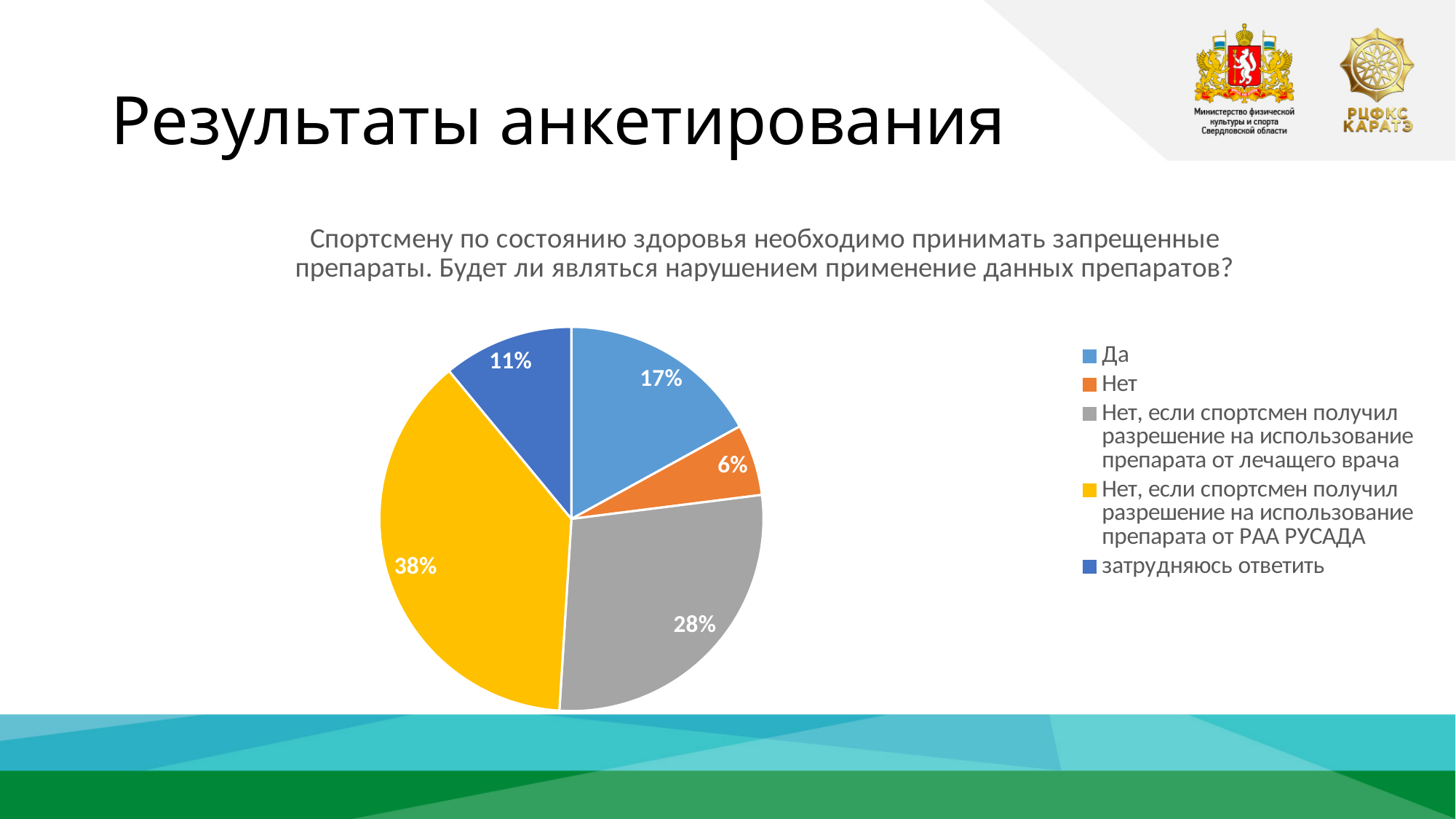
What percentage of respondents answered "Нет"? 6% How many slices does the pie chart have? 5 Which answer option has the largest share of the pie? Нет, если спортсмен получил разрешение на использование препарата от РАА РУСАДА Which is larger: the share for "Да" or the share for "затрудняюсь ответить"? Да What is the difference in percentage points between the "РАА РУСАДА" slice and the "лечащего врача" slice? 10 What percentage of respondents answered "Да"? 17% What percentage of respondents answered "Нет, если спортсмен получил разрешение на использование препарата от РАА РУСАДА"? 38% What percentage of respondents answered "Нет, если спортсмен получил разрешение на использование препарата от лечащего врача"? 28% What percentage of respondents answered "затрудняюсь ответить"? 11% What type of chart is shown on the slide? Pie chart Which answer option has the smallest share of the pie? Нет What colour is the slice for "затрудняюсь ответить"? Dark blue